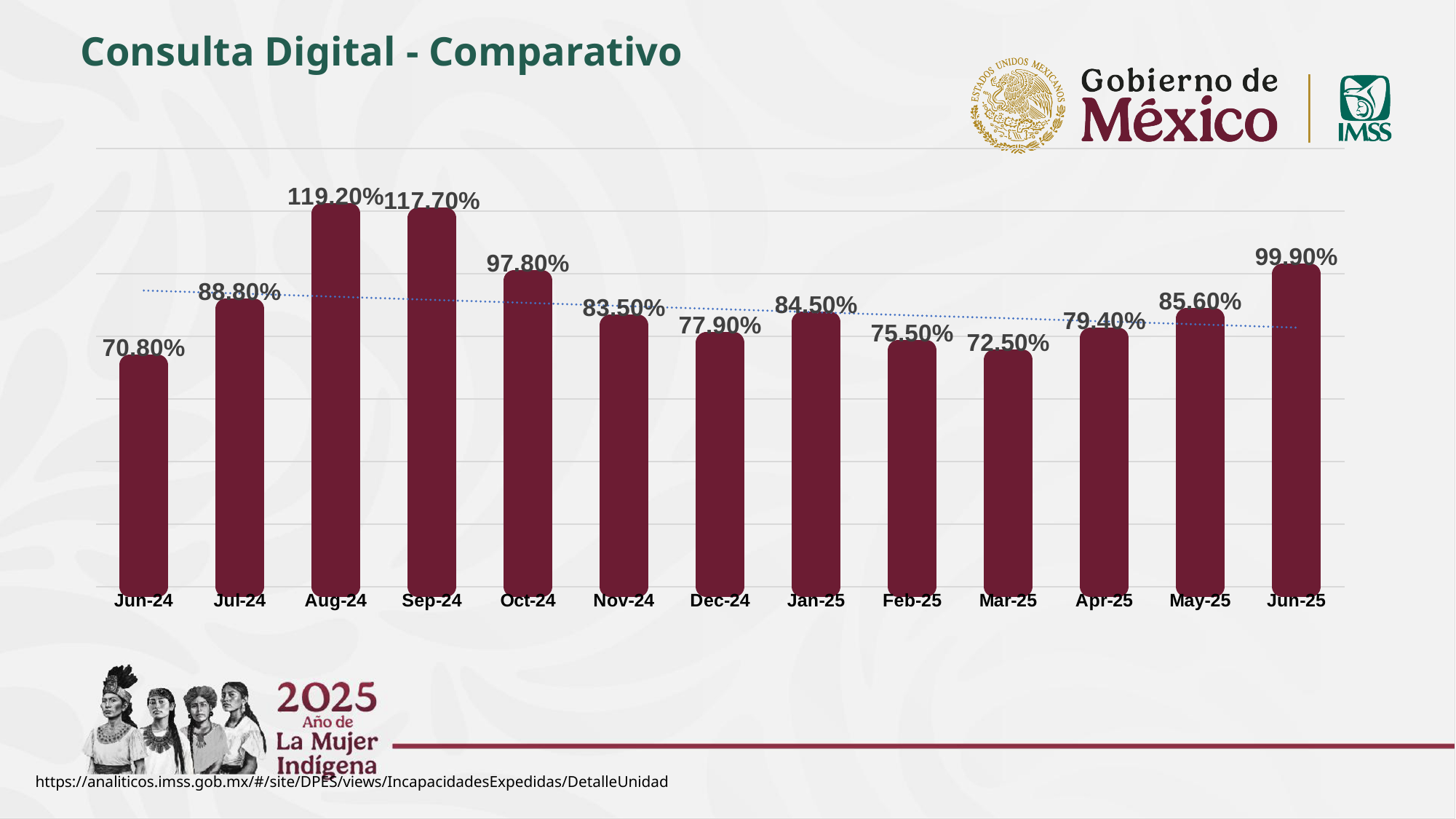
What is the value for Mar-25? 72.50% Which month has the lowest value? Jun-24 Which month has the highest value? Aug-24 Which is larger, the value for Oct-24 or the value for Jun-25? Jun-25 What is the difference between the values for Aug-24 and Sep-24? 1.50 percentage points What is the difference between the values for Jun-25 and Jun-24? 29.10 percentage points What kind of chart is shown on the slide? Bar chart How many months are shown on the x axis? 13 What is the title of the chart? Consulta Digital - Comparativo What is the value for Jan-25? 84.50% What is the value for Aug-24? 119.20% What is the value for Jun-25? 99.90%